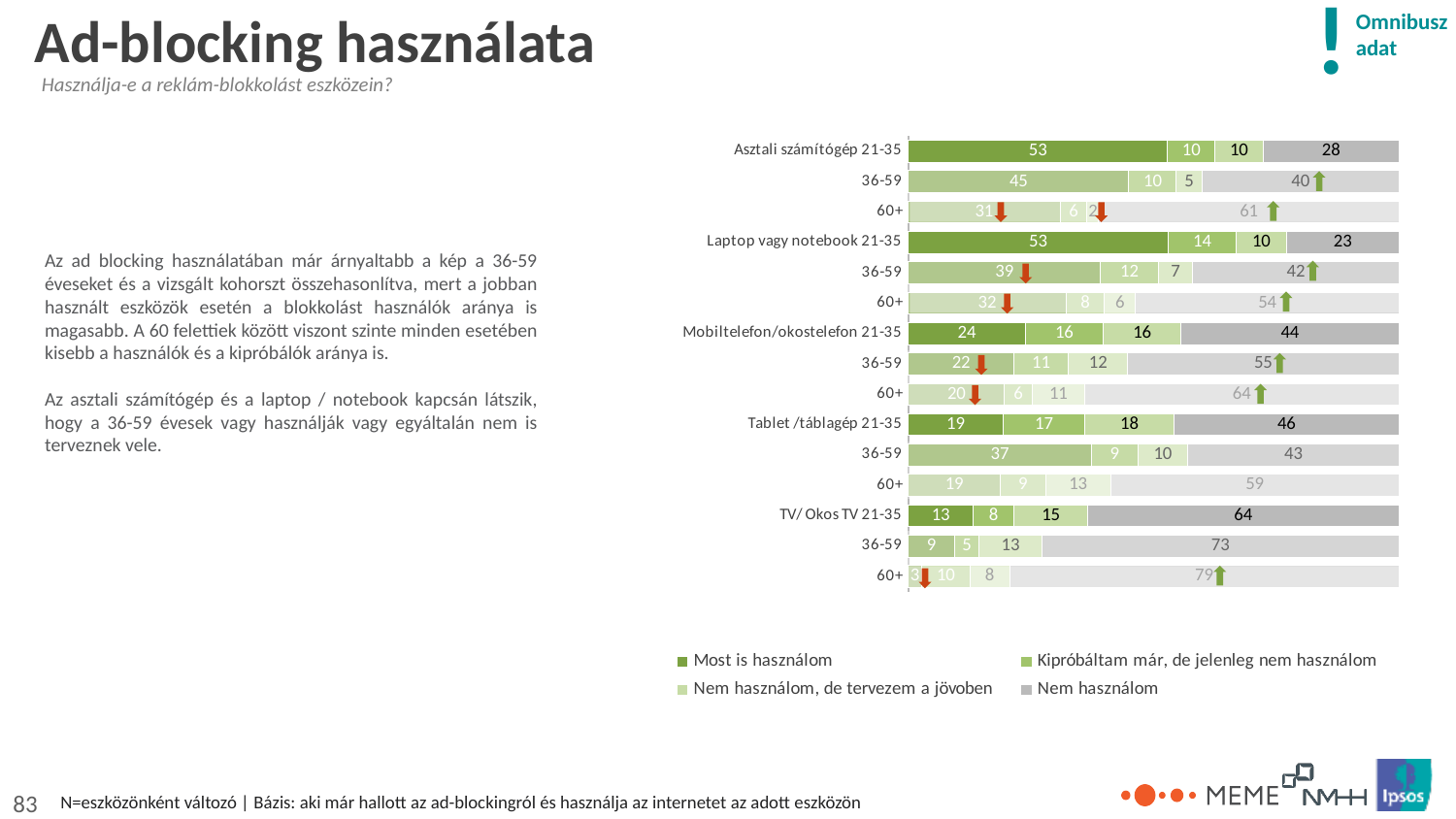
What is the 'Most is használom' value for Asztali számítógép 21-35? 53 Which row has the highest 'Nem használom' value? TV/ Okos TV 60+ How many series does the chart legend list? 4 Which is larger: the 'Most is használom' value for Tablet /táblagép 36-59 or for Mobiltelefon/okostelefon 21-35? Tablet /táblagép 36-59 What is the 'Kipróbáltam már, de jelenleg nem használom' value for Laptop vagy notebook 21-35? 14 What type of chart is shown on the slide? Stacked bar chart What is the difference between the 'Nem használom' values for Asztali számítógép 60+ and Asztali számítógép 21-35? 33 What is the title of the slide containing the chart? Ad-blocking használata Which row has the lowest 'Most is használom' value? TV/ Okos TV 60+ What is the total of the stacked bar for Laptop vagy notebook 21-35? 100 What is the 'Nem használom' value for TV/ Okos TV 36-59? 73 How many bars (device and age-group rows) are plotted in the chart? 15